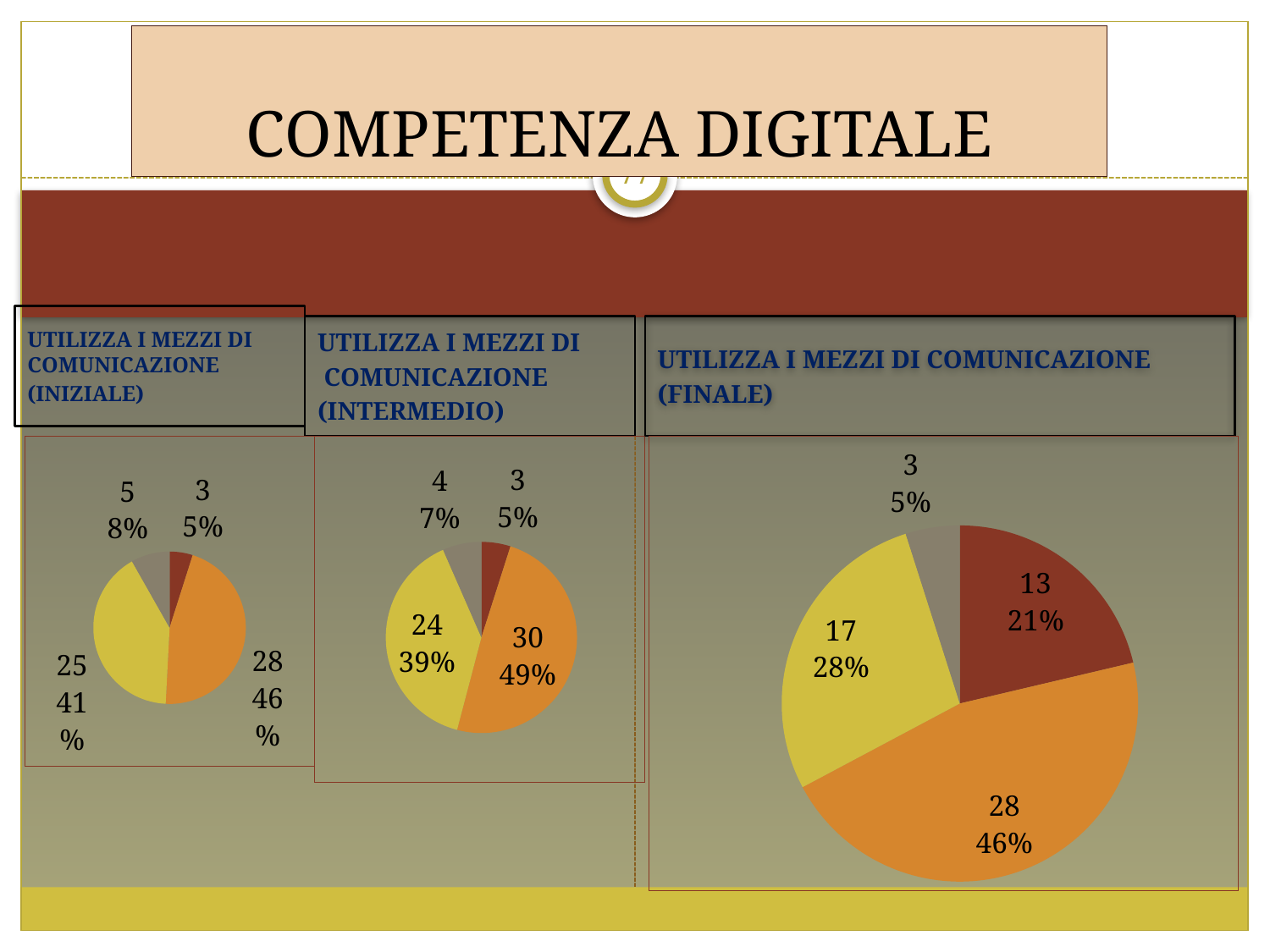
In the 'UTILIZZA I MEZZI DI COMUNICAZIONE (FINALE)' chart, what is the value of the largest slice? 28 In the 'UTILIZZA I MEZZI DI COMUNICAZIONE (FINALE)' chart, what share of the pie does the largest slice represent? 46% In the 'UTILIZZA I MEZZI DI COMUNICAZIONE (INTERMEDIO)' chart, what is the difference between the orange slice value and the yellow slice value? 6 How many pie charts are shown on the slide? 3 Which chart has the larger value for its dark red slice, 'UTILIZZA I MEZZI DI COMUNICAZIONE (INIZIALE)' or 'UTILIZZA I MEZZI DI COMUNICAZIONE (FINALE)'? UTILIZZA I MEZZI DI COMUNICAZIONE (FINALE) What is the total of all slice values in the 'UTILIZZA I MEZZI DI COMUNICAZIONE (FINALE)' chart? 61 In the 'UTILIZZA I MEZZI DI COMUNICAZIONE (INTERMEDIO)' chart, what is the value of the smallest slice? 3 In the 'UTILIZZA I MEZZI DI COMUNICAZIONE (FINALE)' chart, what value is shown for the dark red slice? 13 In the 'UTILIZZA I MEZZI DI COMUNICAZIONE (INTERMEDIO)' chart, what percentage is shown for the orange slice? 49% In the 'UTILIZZA I MEZZI DI COMUNICAZIONE (INIZIALE)' chart, what percentage is shown for the yellow slice? 41% What kind of chart is used in the 'UTILIZZA I MEZZI DI COMUNICAZIONE (FINALE)' chart? pie chart How many slices does the 'UTILIZZA I MEZZI DI COMUNICAZIONE (INIZIALE)' pie chart have? 4